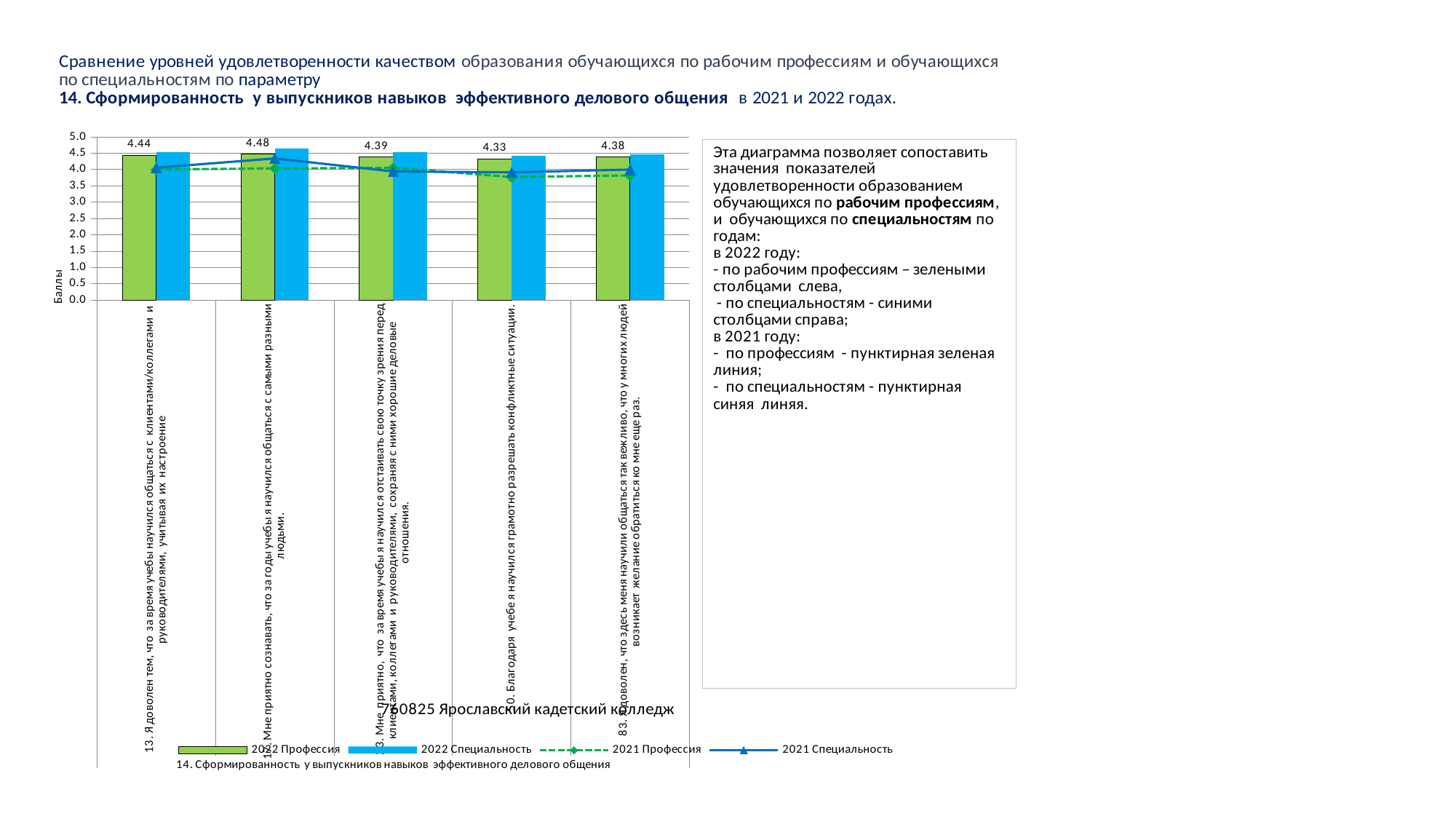
Is the 2022 Специальность value for the first statement greater or less than 4.0? greater How many statements (categories) are plotted along the x axis? 5 Which statement has the highest labelled 2022 Профессия value? The second statement (Мне приятно сознавать, что за годы учебы я научился общаться с самыми разными людьми), 4.48 What is the label of the vertical axis of the chart? Баллы What kind of chart is shown on the slide? A bar chart combined with line series What is the labelled 2022 Профессия value for the last statement (83. Я доволен, что здесь меня научили общаться так вежливо...)? 4.38 Which is larger: the labelled 2022 Профессия value for the first statement or for the last statement? The first statement (4.44) Which statement has the lowest labelled 2022 Профессия value? The fourth statement (Благодаря учебе я научился грамотно разрешать конфликтные ситуации), 4.33 How many series does the chart legend list? 4 What is the difference between the highest (4.48) and lowest (4.33) labelled 2022 Профессия values? 0.15 What is the labelled 2022 Профессия value for the first statement (13. Я доволен тем, что за время учебы научился общаться с клиентами/коллегами и руководителями...)? 4.44 What colour are the 2022 Профессия bars in the chart? Green